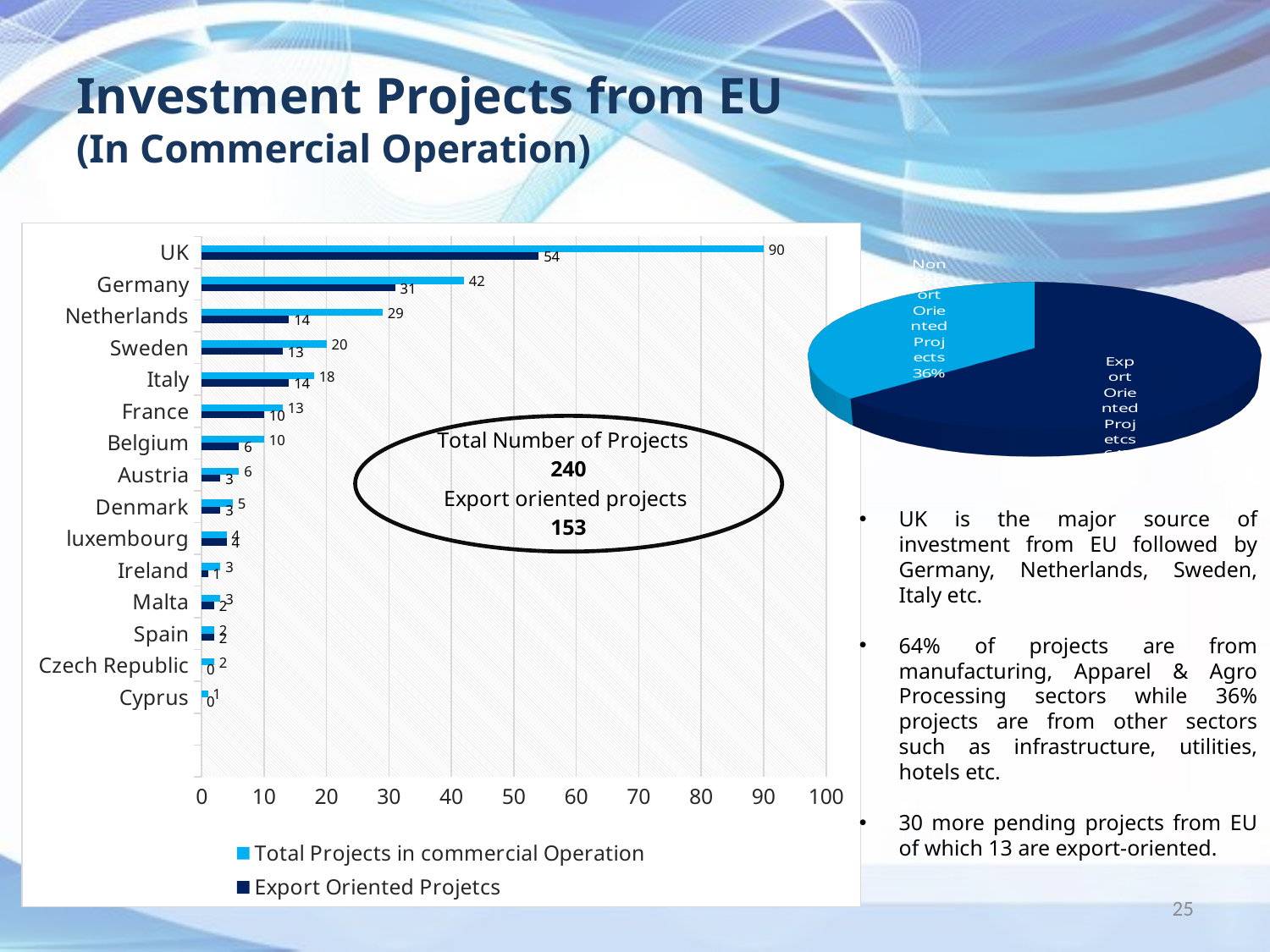
How many series does the legend of the bar chart list? 2 In the bar chart, which country has the lowest number of Total Projects in commercial Operation? Cyprus In the bar chart, is the value of Total Projects in commercial Operation for Germany greater or less than 40? greater In the bar chart, what is the difference between the UK's Total Projects in commercial Operation and its Export Oriented Projects? 36 In the bar chart, which country has the highest number of Total Projects in commercial Operation? UK In the bar chart, which has more Total Projects in commercial Operation, Netherlands or Sweden? Netherlands What type of chart is shown in the top right of the slide? Pie chart How many countries are shown in the bar chart? 15 What type of chart is the chart on the left side of the slide? Bar chart In the pie chart, what share of projects are Non Export Oriented Projects? 36% In the bar chart, what is the value of Total Projects in commercial Operation for the UK? 90 In the bar chart, how many Export Oriented Projects does Germany have? 31